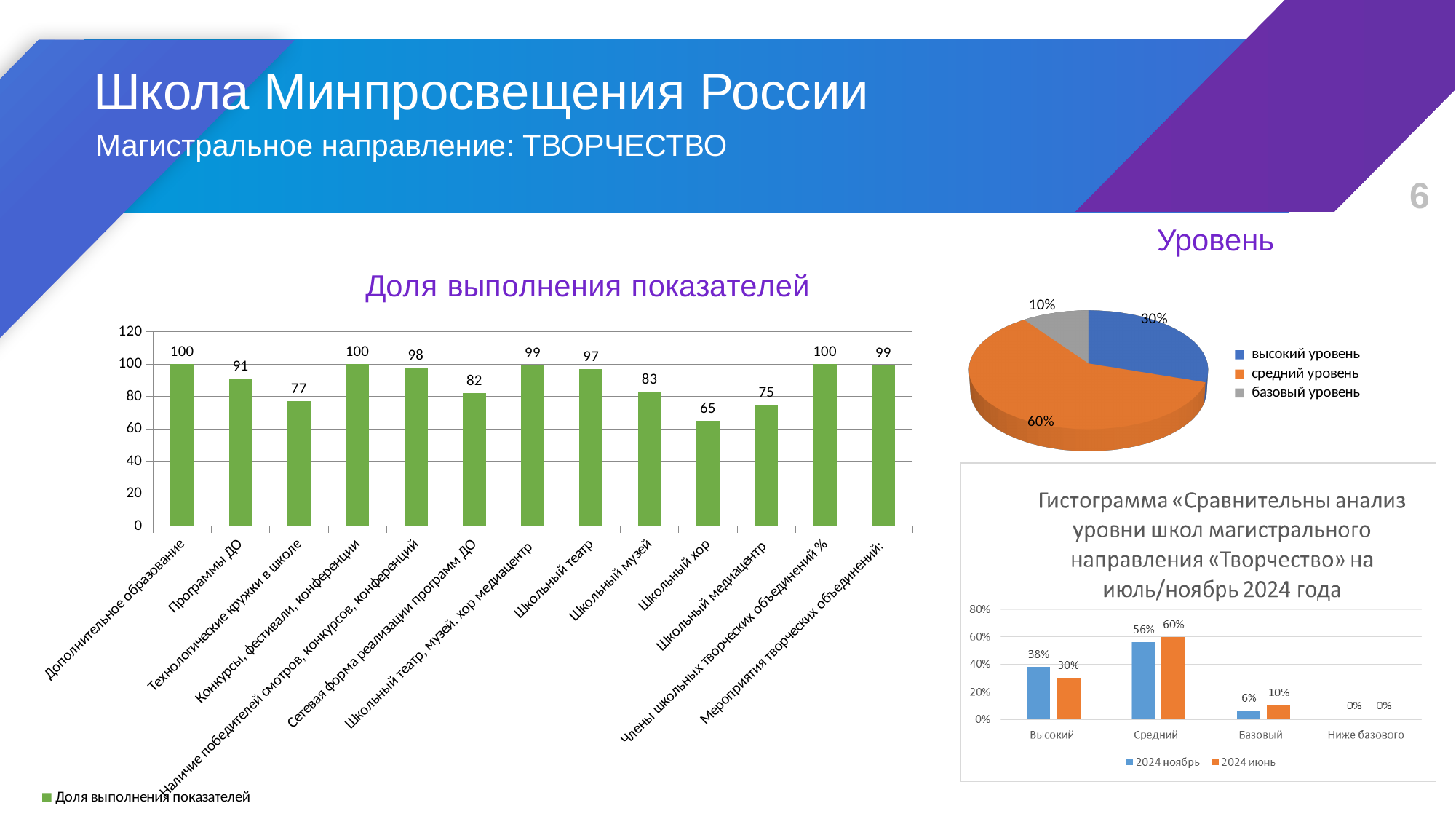
In the chart "Доля выполнения показателей", which is larger: Школьный музей or Сетевая форма реализации программ ДО? Школьный музей In the chart "Доля выполнения показателей", what is the value for Технологические кружки в школе? 77 In the chart "Доля выполнения показателей", what is the difference between the values for Программы ДО and Школьный медиацентр? 16 In the histogram chart at the bottom right, what is the value for Высокий in 2024 ноябрь? 38% In the chart "Доля выполнения показателей", how many categories are shown? 13 In the chart "Доля выполнения показателей", which category has the lowest value? Школьный хор In the pie chart "Уровень", which level has the smallest slice? базовый уровень In the pie chart "Уровень", what share does средний уровень have? 60% In the histogram chart at the bottom right, what is the difference between the 2024 июнь and 2024 ноябрь values for Базовый? 4% What kind of chart is the chart titled "Уровень"? pie chart In the histogram chart at the bottom right, how many series does the legend list? 2 In the chart "Доля выполнения показателей", what is the value for Школьный хор? 65